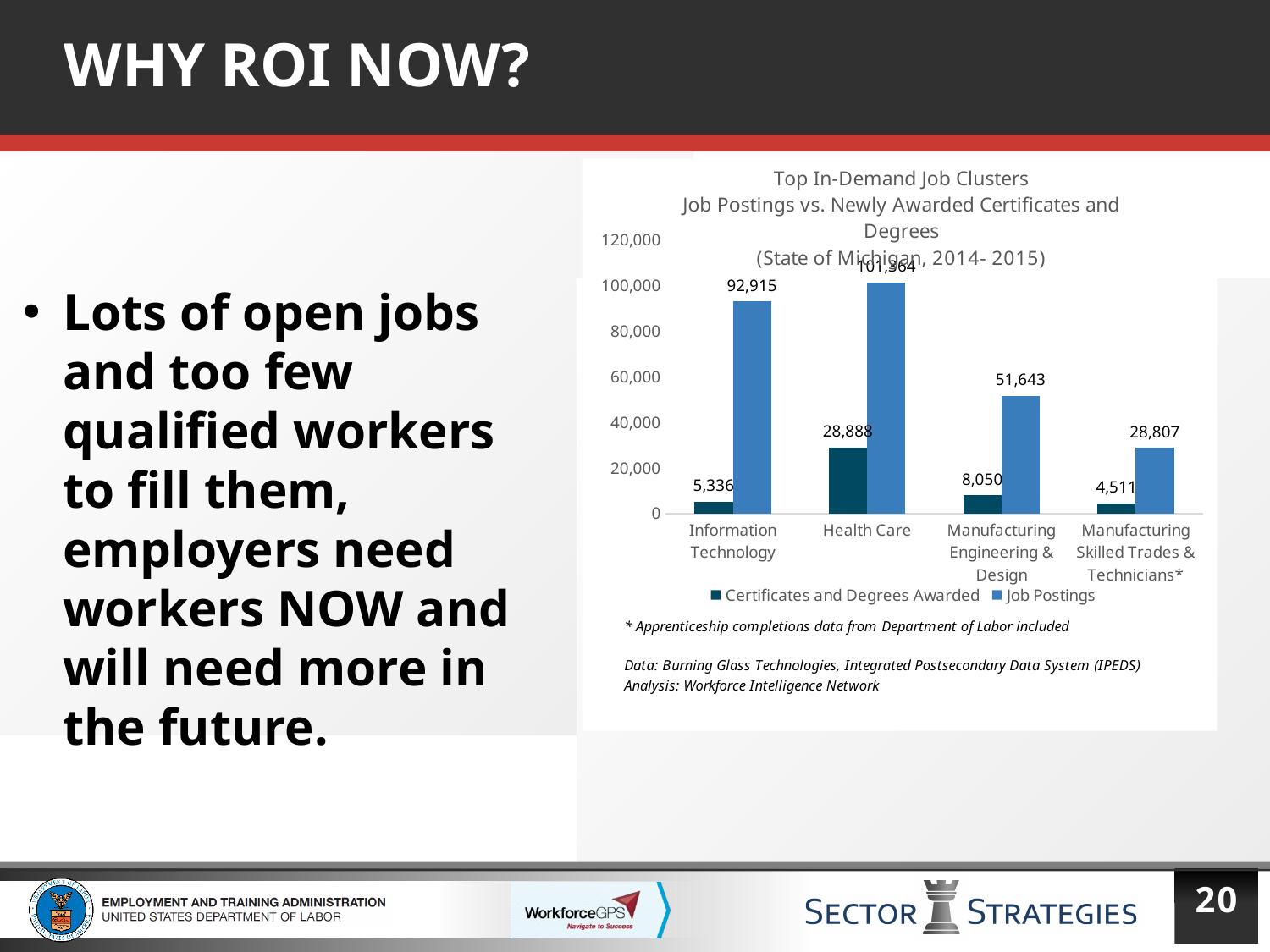
Which has more Job Postings: Manufacturing Engineering & Design or Manufacturing Skilled Trades & Technicians? Manufacturing Engineering & Design Is the Job Postings value for Health Care greater or less than 100,000? greater What is the Certificates and Degrees Awarded value for Manufacturing Skilled Trades & Technicians? 4,511 What kind of chart is shown on the slide? bar chart What is the difference between Job Postings and Certificates and Degrees Awarded for Information Technology? 87,579 How many job clusters are shown on the x axis? 4 How many Certificates and Degrees Awarded are shown for Health Care? 28,888 Which job cluster has the highest number of Job Postings? Health Care What is the value of Job Postings for Information Technology? 92,915 Which job cluster has the lowest number of Certificates and Degrees Awarded? Manufacturing Skilled Trades & Technicians How many series does the legend list? 2 What is the Job Postings value for Manufacturing Engineering & Design? 51,643